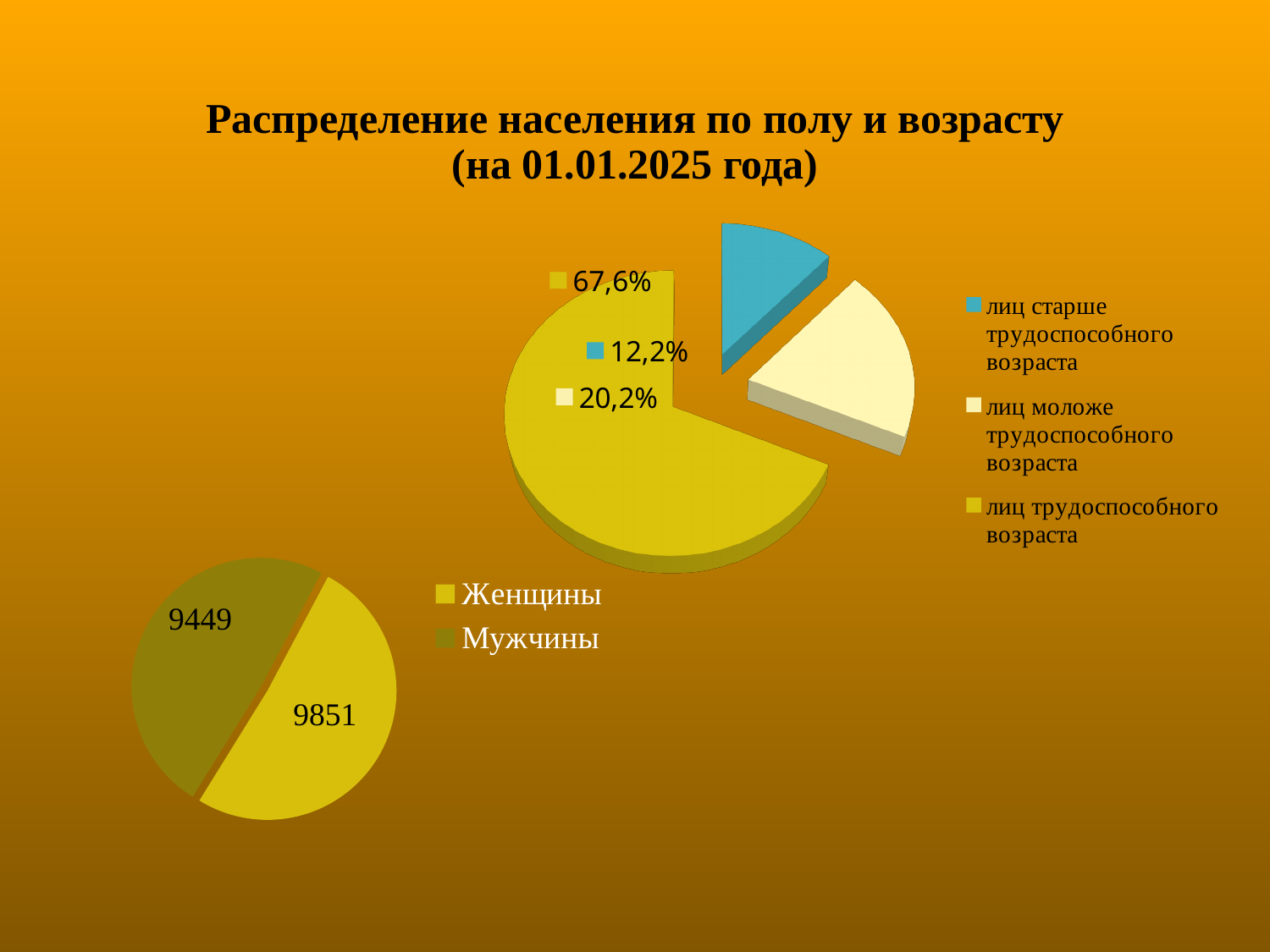
In the lower-left pie chart on gender, which group is larger, Женщины or Мужчины? Женщины In the lower-left pie chart on gender, what value is shown for Женщины? 9851 In the upper-right pie chart on age groups, how many categories does the legend list? 3 In the lower-left pie chart on gender, what is the difference between the values for Женщины and Мужчины? 402 In the lower-left pie chart on gender, what value is shown for Мужчины? 9449 In the upper-right pie chart on age groups, what percentage is shown for лиц трудоспособного возраста? 67,6% In the upper-right pie chart on age groups, what percentage is shown for лиц старше трудоспособного возраста? 12,2% In the upper-right pie chart on age groups, how many percentage points larger is the share of лиц моложе трудоспособного возраста than that of лиц старше трудоспособного возраста? 8,0 In the upper-right pie chart on age groups, which category has the largest share? лиц трудоспособного возраста In the upper-right pie chart on age groups, what percentage is shown for лиц моложе трудоспособного возраста? 20,2% What type of chart is the lower-left chart on gender? Pie chart In the upper-right pie chart on age groups, which category has the smallest share? лиц старше трудоспособного возраста